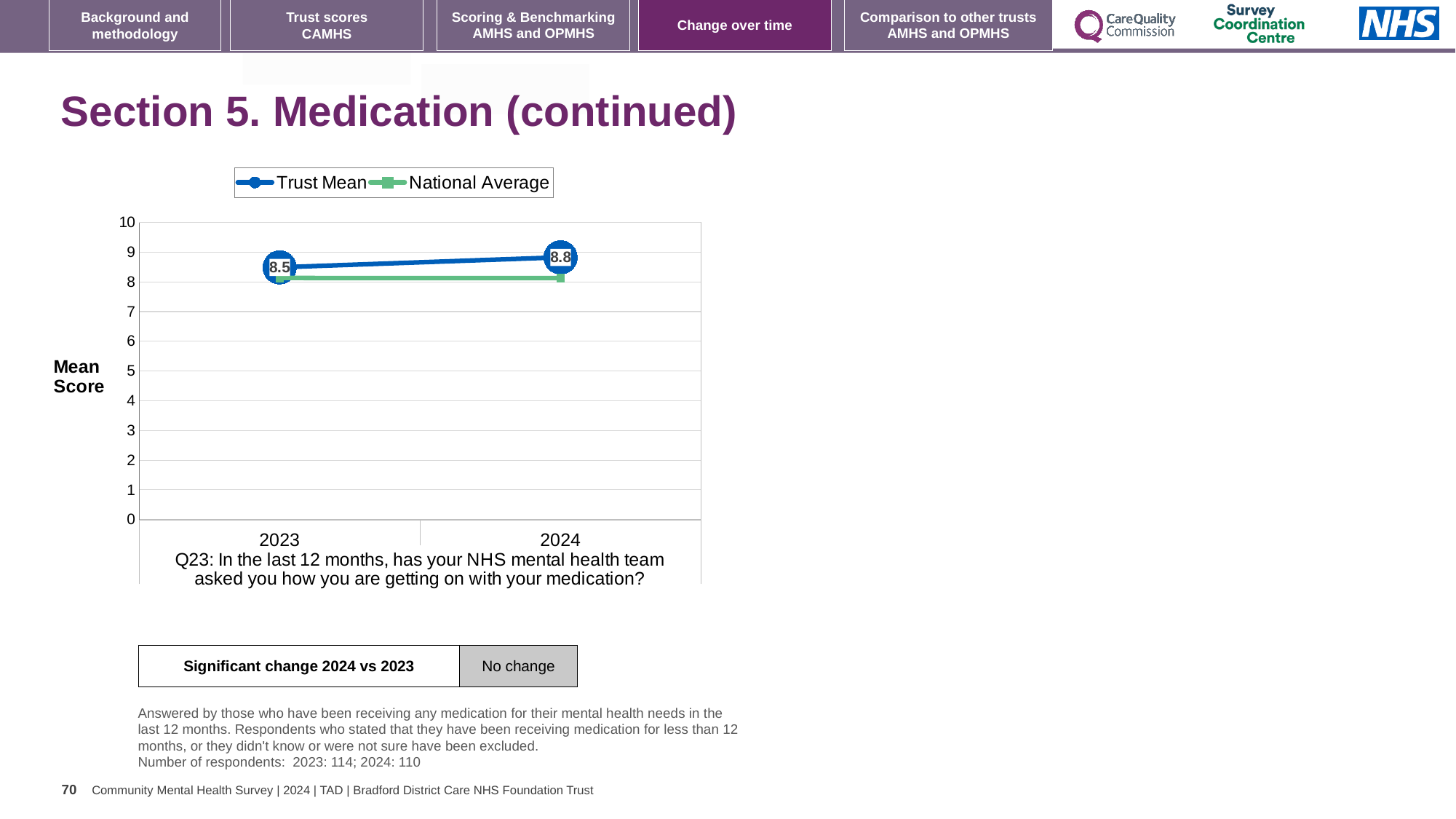
What is the Trust Mean value for 2024? 8.8 Does the Trust Mean rise or fall from 2023 to 2024? rise In 2024, which is larger, the Trust Mean or the National Average? Trust Mean Which year has the higher Trust Mean, 2023 or 2024? 2024 What is the Trust Mean value for 2023? 8.5 How many series does the legend list? 2 How many years are plotted on the x axis? 2 What kind of chart is shown on the slide? line chart Is the National Average value for 2024 greater or less than 9? less What is the label on the y axis of the chart? Mean Score Is the National Average value for 2023 greater or less than 7? greater By how much did the Trust Mean change from 2023 to 2024? 0.3